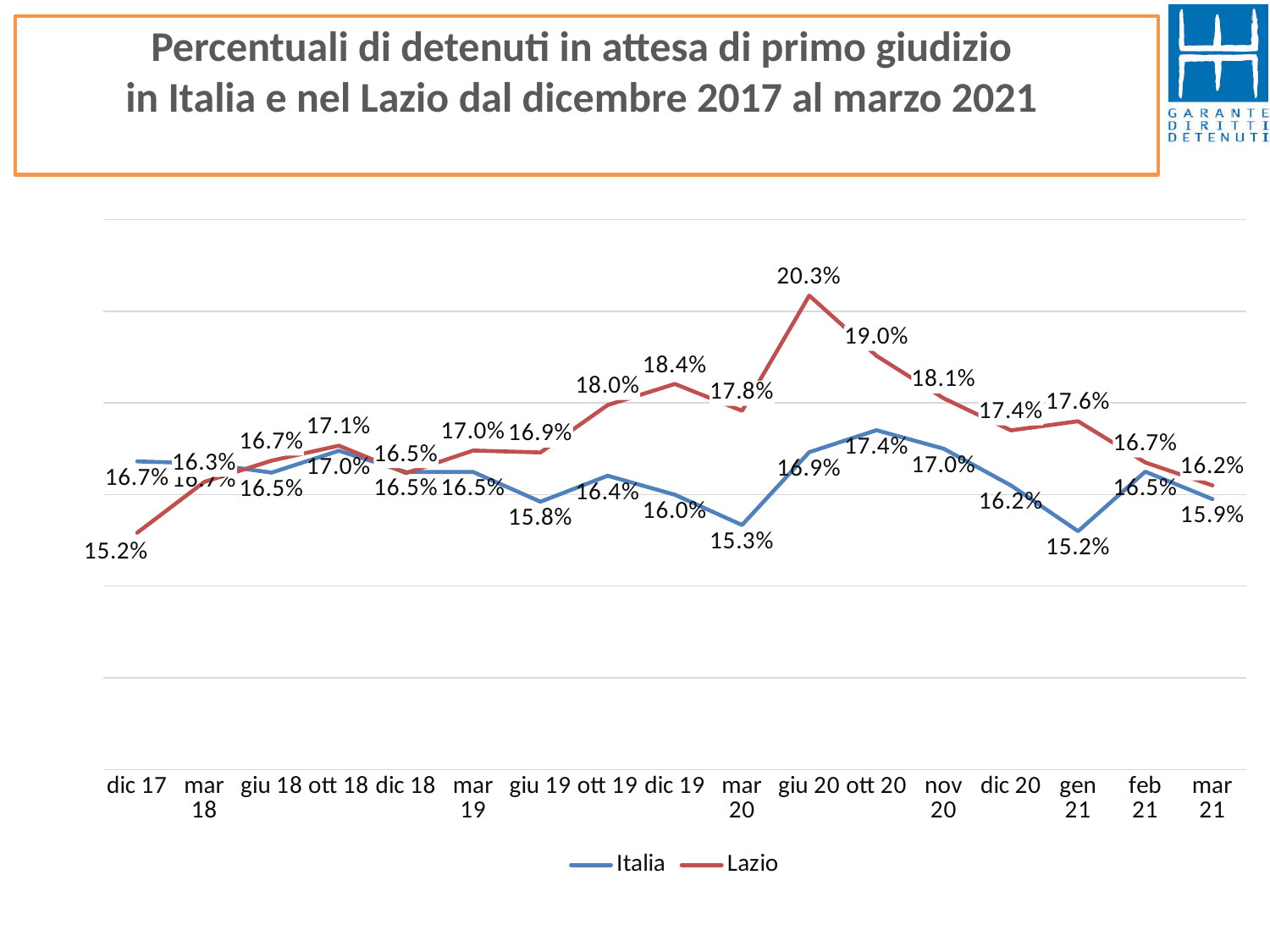
How many series does the legend list? 2 In which period does the Lazio series reach its highest value? giu 20 What kind of chart is shown on the slide? line chart What is the value for Italia in mar 20? 15.3% Which colour is used for the Lazio line? red Which series has the higher value in dic 17, Italia or Lazio? Italia What is the value for Italia in ott 20? 17.4% What is the value for Lazio in dic 19? 18.4% How many time points are plotted along the x axis? 17 What is the difference between the Lazio and Italia values in giu 20? 3.4 percentage points What is the value for Lazio in giu 20? 20.3% In which period does the Lazio series have its lowest value? dic 17